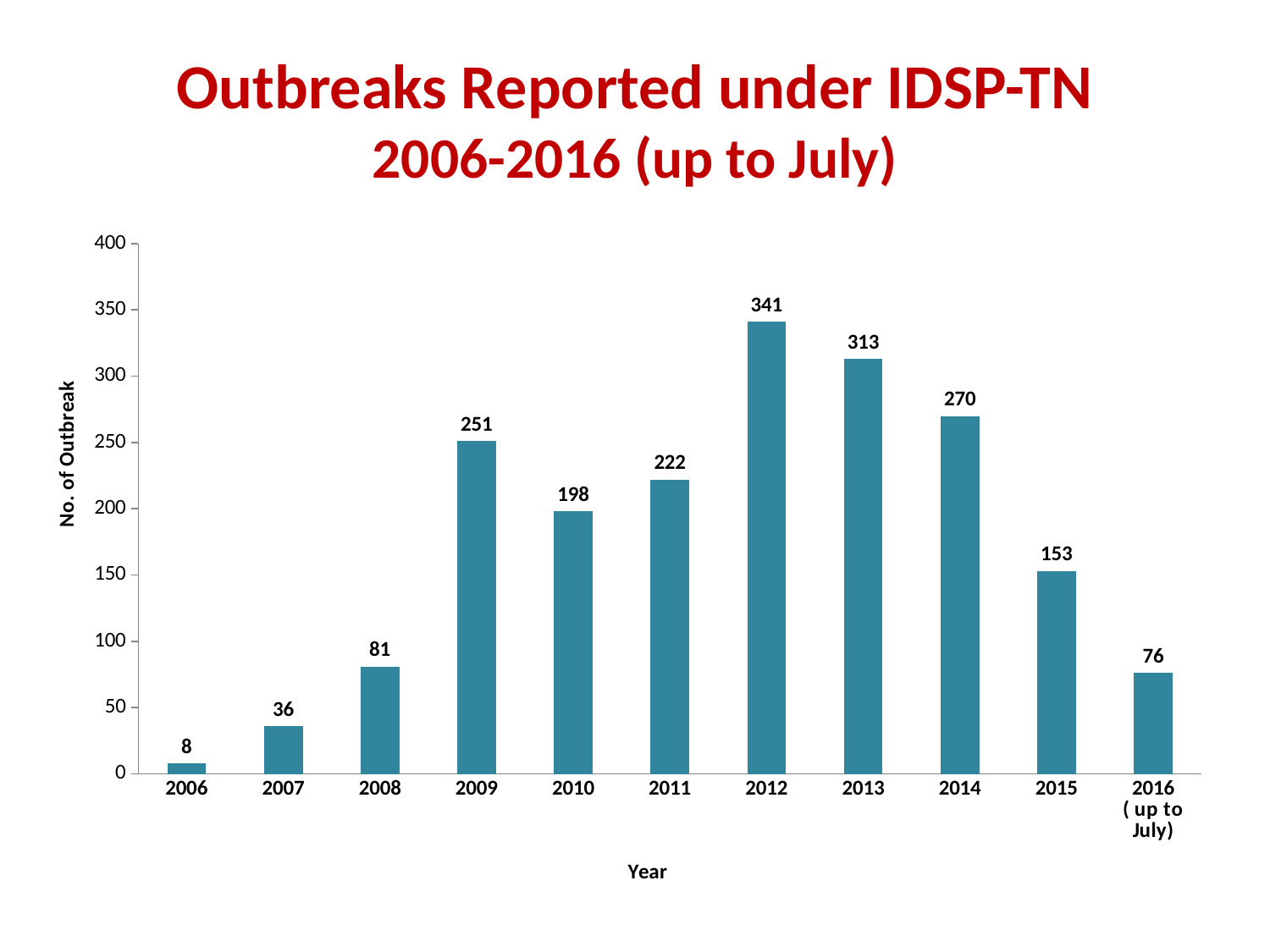
Which year has the lowest number of outbreaks? 2006 How many more outbreaks were reported in 2014 than in 2015? 117 Which year had more outbreaks, 2010 or 2011? 2011 What is the number of outbreaks shown for 2009? 251 What type of chart is shown on the slide? Bar chart How many outbreaks were reported in 2012? 341 Is the value for 2008 greater or less than 100? less How many years (bars) are shown on the chart? 11 Which year has the highest number of outbreaks? 2012 What is the difference in outbreaks between 2012 and 2013? 28 What is the label of the vertical axis? No. of Outbreak How many outbreaks are shown for 2016 (up to July)? 76